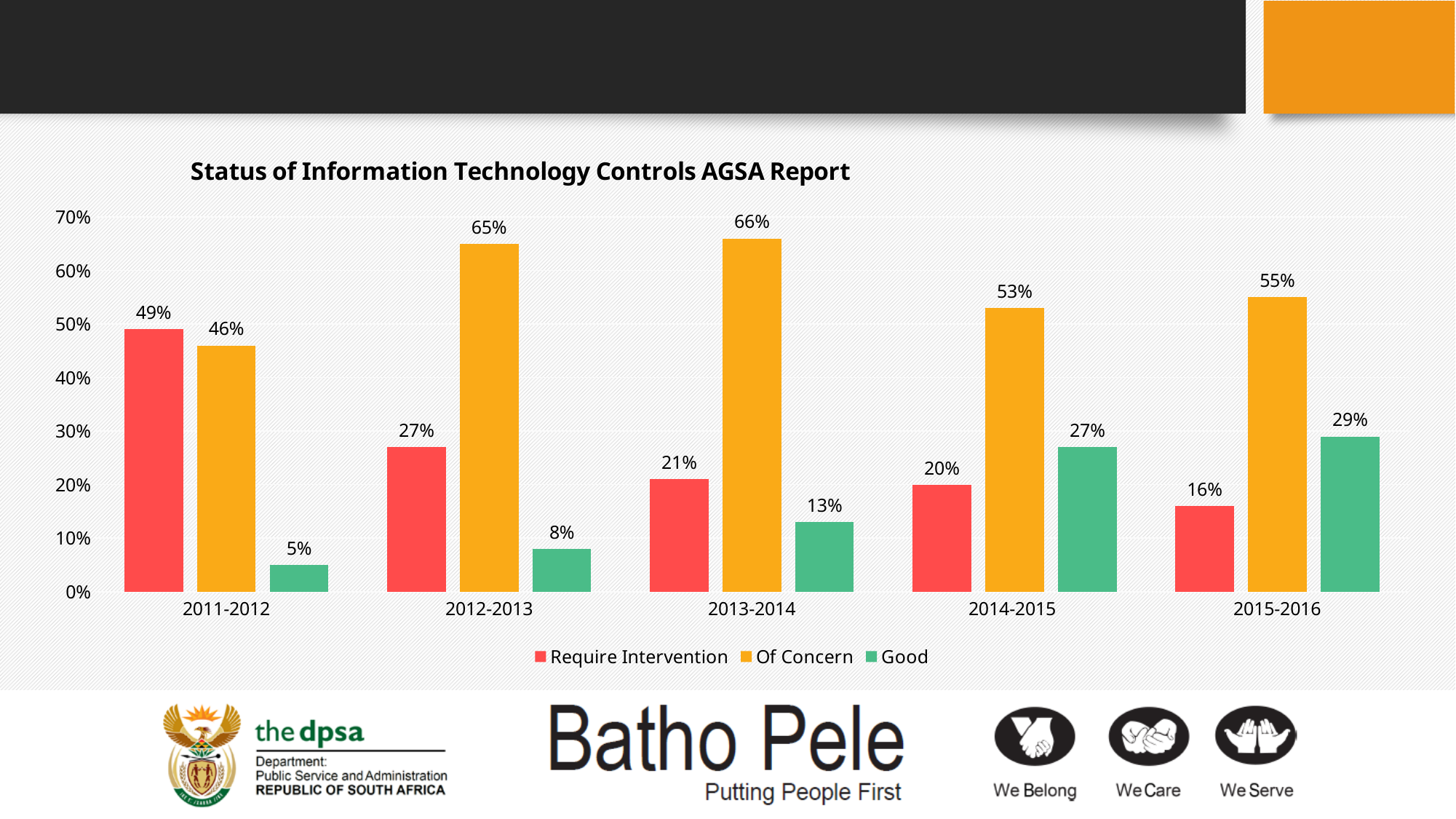
What is the value for Good in 2015-2016? 29% What is the value for Of Concern in 2013-2014? 66% In which year is the Require Intervention series lowest? 2015-2016 Which is larger in 2011-2012: Require Intervention or Of Concern? Require Intervention What kind of chart is shown? Bar chart Does the Good series rise or fall from 2011-2012 to 2015-2016? Rise How many series does the legend list? 3 In which year is the Good series highest? 2015-2016 What is the value for Require Intervention in 2011-2012? 49% How many year categories are shown on the x axis? 5 What is the difference between Of Concern and Require Intervention in 2012-2013? 38% What is the title of the chart? Status of Information Technology Controls AGSA Report